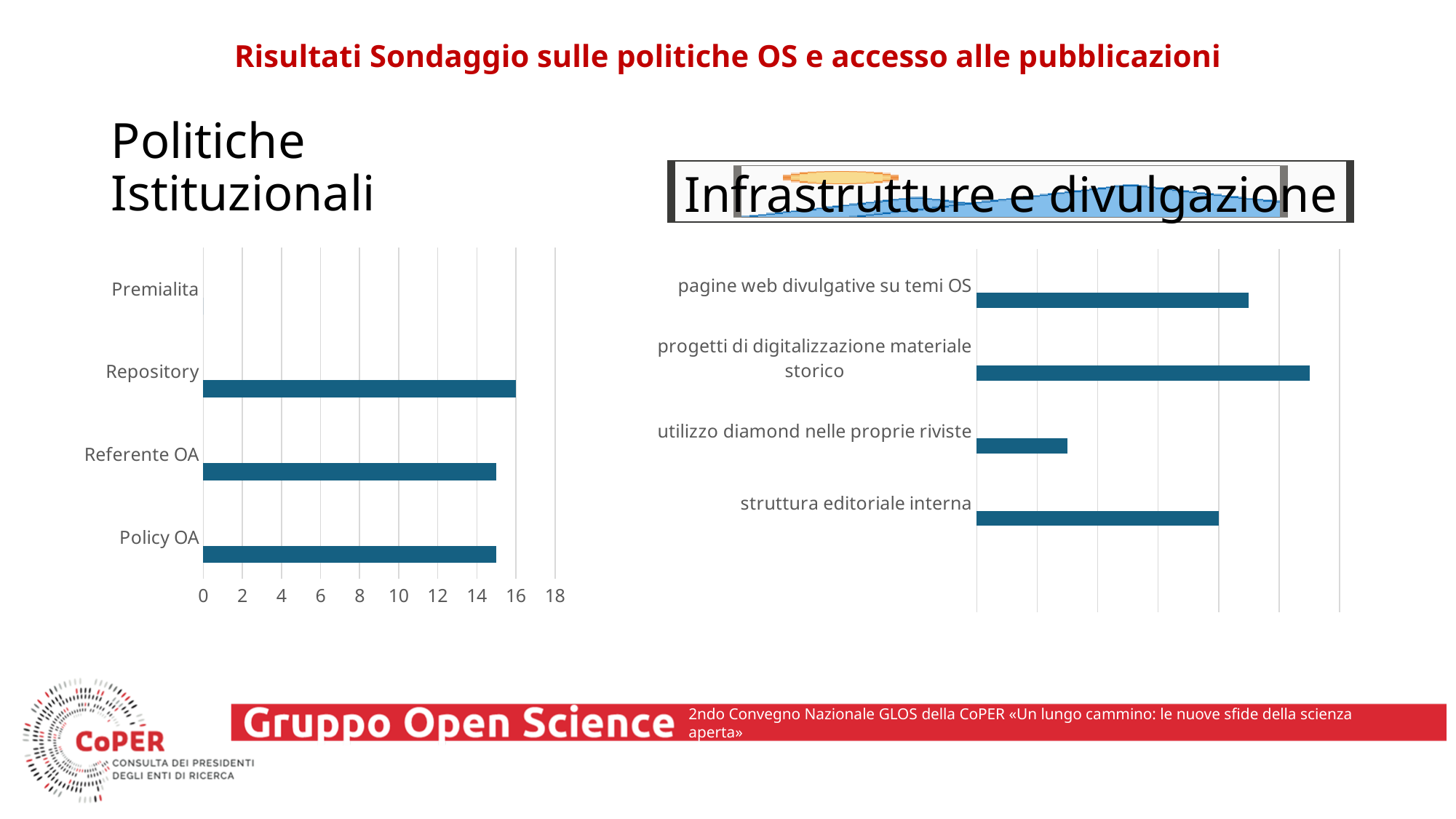
In the 'Politiche Istituzionali' chart, what is the value for Repository? 16 In the 'Infrastrutture e divulgazione' chart, which category has the lowest value? utilizzo diamond nelle proprie riviste In the 'Politiche Istituzionali' chart, which category has the highest value? Repository In the 'Infrastrutture e divulgazione' chart, which is larger, the value for 'progetti di digitalizzazione materiale storico' or the value for 'utilizzo diamond nelle proprie riviste'? progetti di digitalizzazione materiale storico In the 'Politiche Istituzionali' chart, which category has the lowest value? Premialita In the 'Politiche Istituzionali' chart, is the value for Referente OA greater or less than 14? greater In the 'Politiche Istituzionali' chart, is the value for Policy OA greater or less than 16? less In the 'Politiche Istituzionali' chart, which is larger, the value for Repository or the value for Premialita? Repository In the 'Infrastrutture e divulgazione' chart, which category has the highest value? progetti di digitalizzazione materiale storico What kind of chart is the 'Politiche Istituzionali' chart? bar chart How many categories are shown in the 'Politiche Istituzionali' chart? 4 How many categories are shown in the 'Infrastrutture e divulgazione' chart? 4